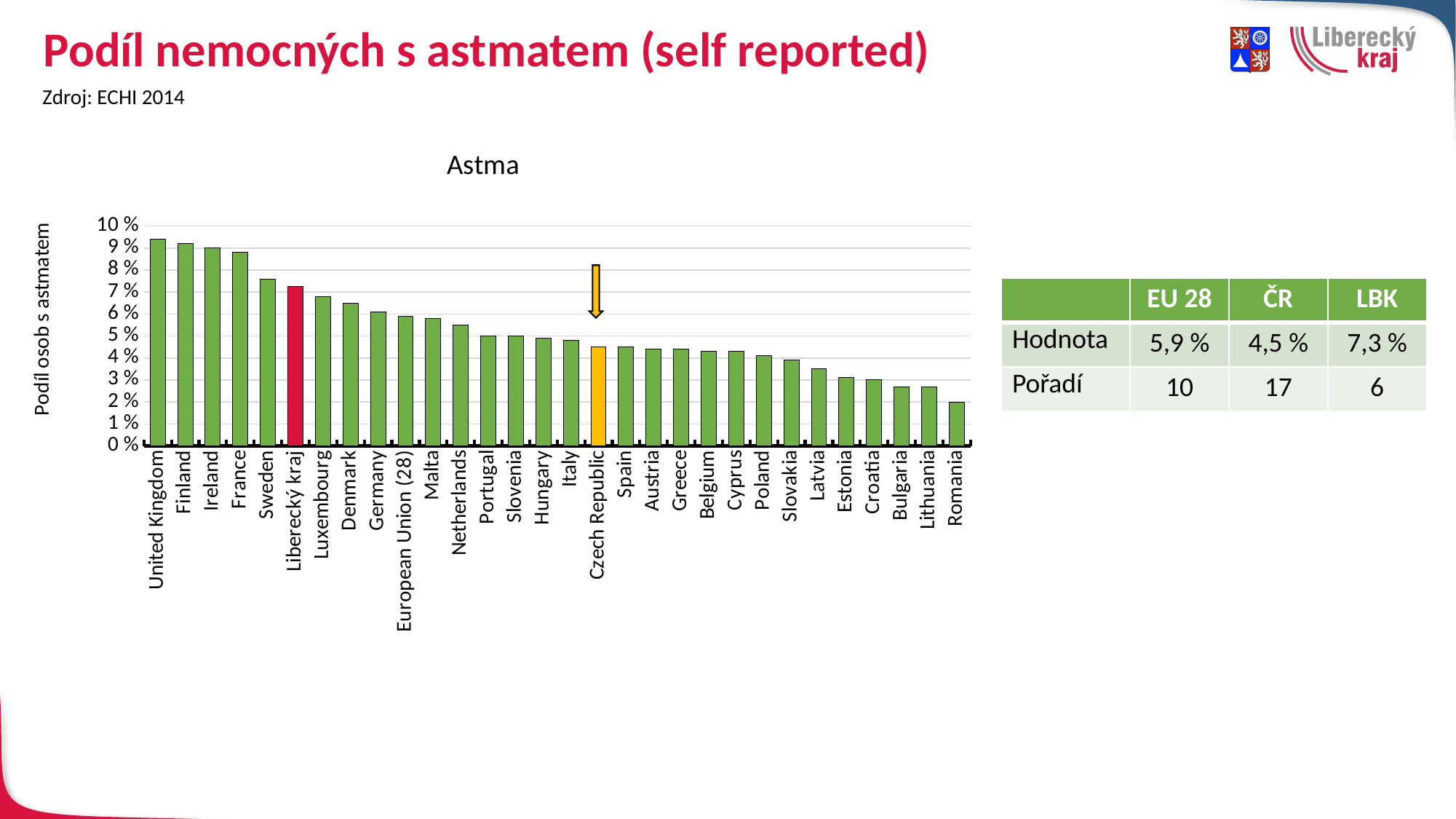
What kind of chart is shown on the slide? bar chart Which category has the lowest share of people with asthma in the chart? Romania Which has the larger value, Liberecký kraj or Czech Republic? Liberecký kraj Is the value for United Kingdom greater or less than 9 %? greater How many countries/regions are plotted on the x axis of the chart? 30 Is the value for Romania greater or less than 3 %? less What colour is the bar for Czech Republic? yellow Is the value for Latvia greater or less than 4 %? less What is the title of the chart? Astma Which has the larger value, France or Sweden? France Do the values rise or fall moving from left to right along the x axis? fall